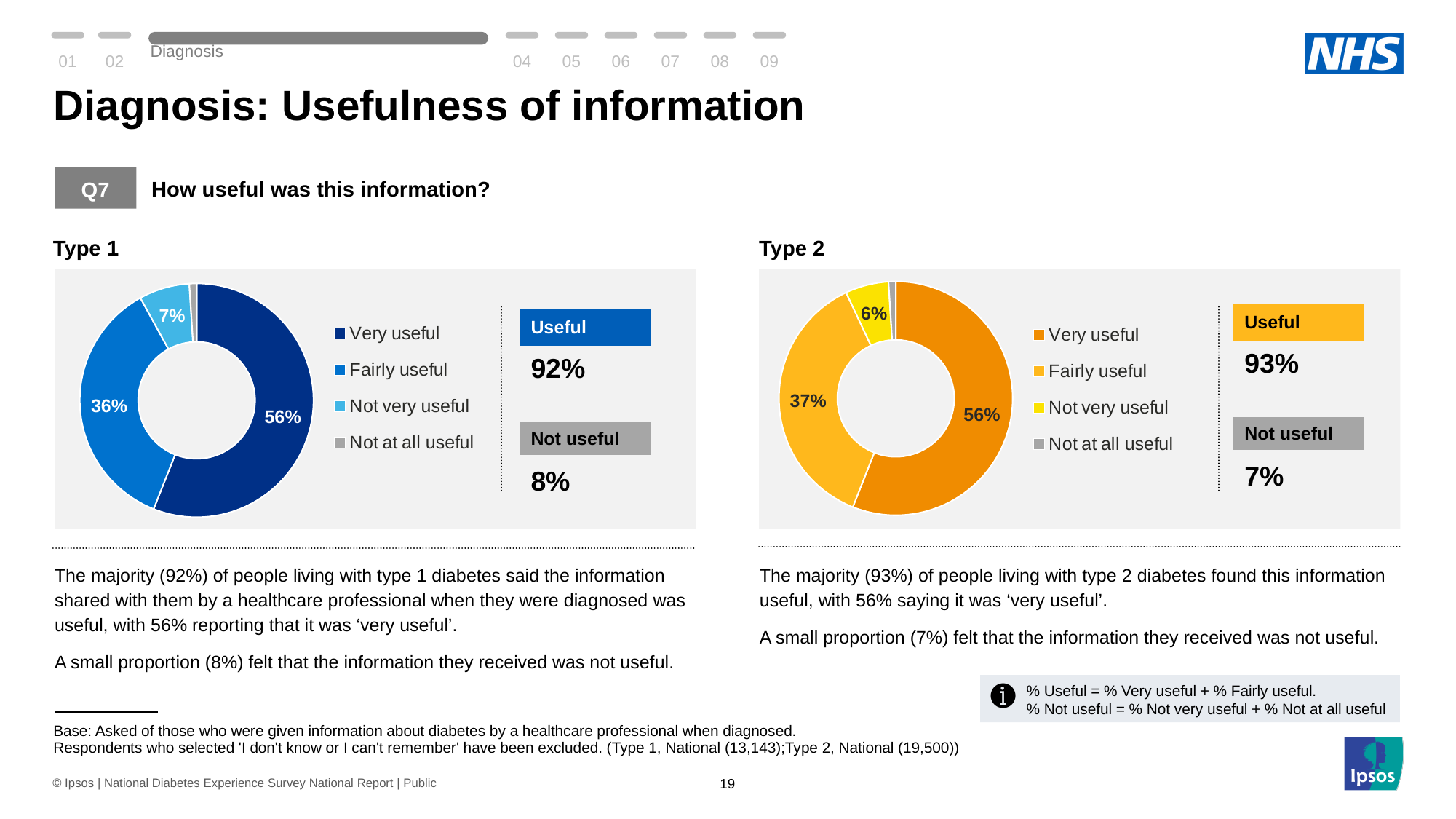
Which is larger: 'Not very useful' in the Type 1 chart or 'Not very useful' in the Type 2 chart? Type 1 In the Type 1 chart, what percentage said the information was 'Very useful'? 56% In the Type 1 chart, what is the difference in percentage points between 'Very useful' and 'Fairly useful'? 20 How many categories does the legend of the Type 2 chart list? 4 In the Type 2 chart, what colour represents 'Very useful'? Orange In the Type 2 chart, what is the combined 'Useful' percentage shown? 93% In the Type 2 chart, which category has the smallest share? Not at all useful What kind of chart is used for Type 1? Pie (donut) chart In the Type 2 chart, what percentage said the information was 'Fairly useful'? 37% In the Type 1 chart, what percentage said the information was 'Not very useful'? 7% In the Type 1 chart, what is the combined 'Not useful' percentage shown? 8% In the Type 1 chart, which category has the largest share? Very useful